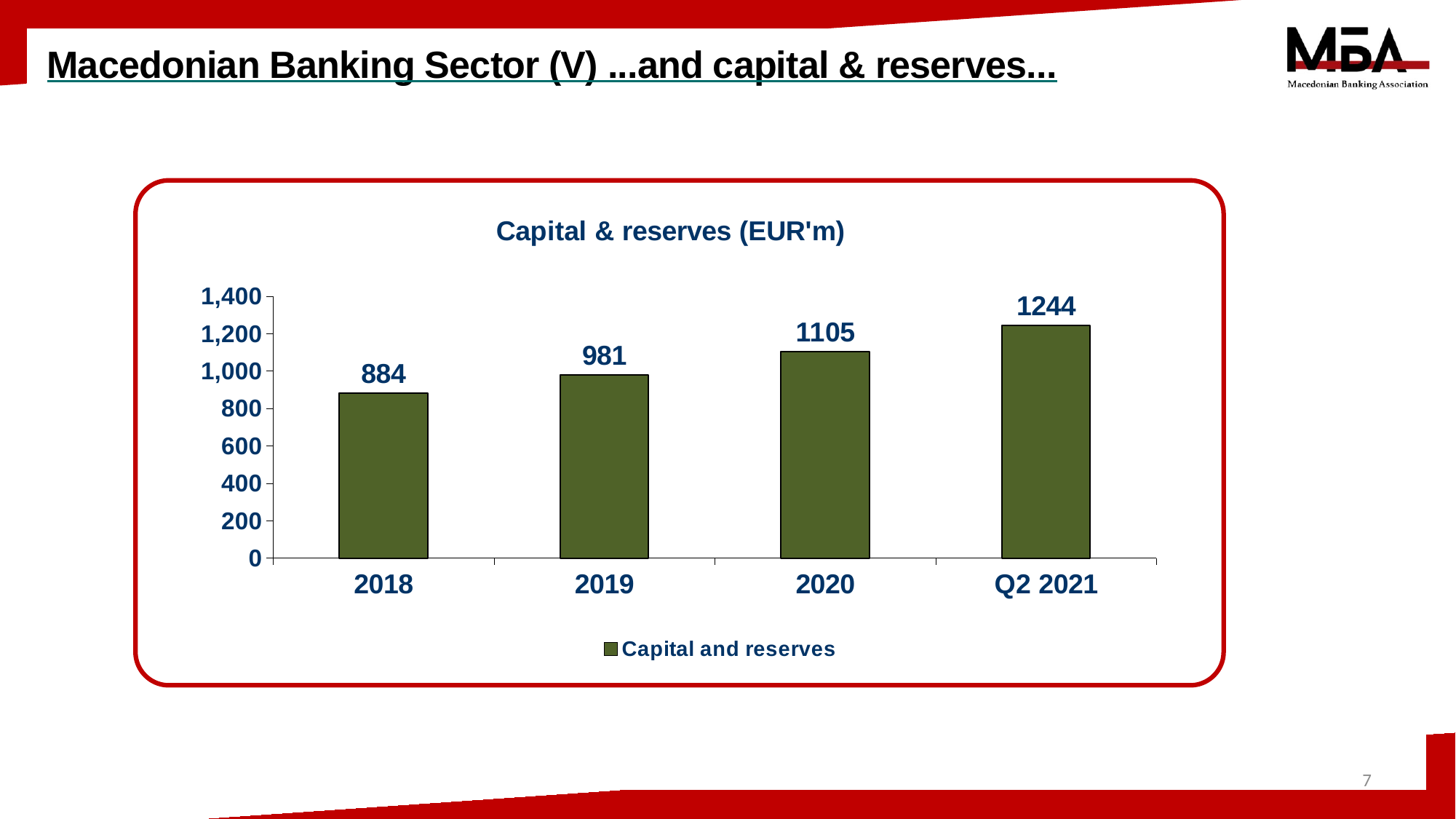
What is the value for 2020 in the Capital & reserves chart? 1105 Which is larger, the value for 2019 or the value for 2020? 2020 How many series does the legend list? 1 What is the value for 2018 in the Capital & reserves chart? 884 What is the value for Q2 2021 in the Capital & reserves chart? 1244 What is the difference between the values for 2020 and 2019? 124 What is the difference between the values for Q2 2021 and 2018? 360 How many periods are shown on the x axis of the chart? 4 What kind of chart is shown on the slide? Bar chart Which period has the lowest capital and reserves value? 2018 Which period has the highest capital and reserves value? Q2 2021 Do the capital and reserves values rise or fall from 2018 to Q2 2021? Rise